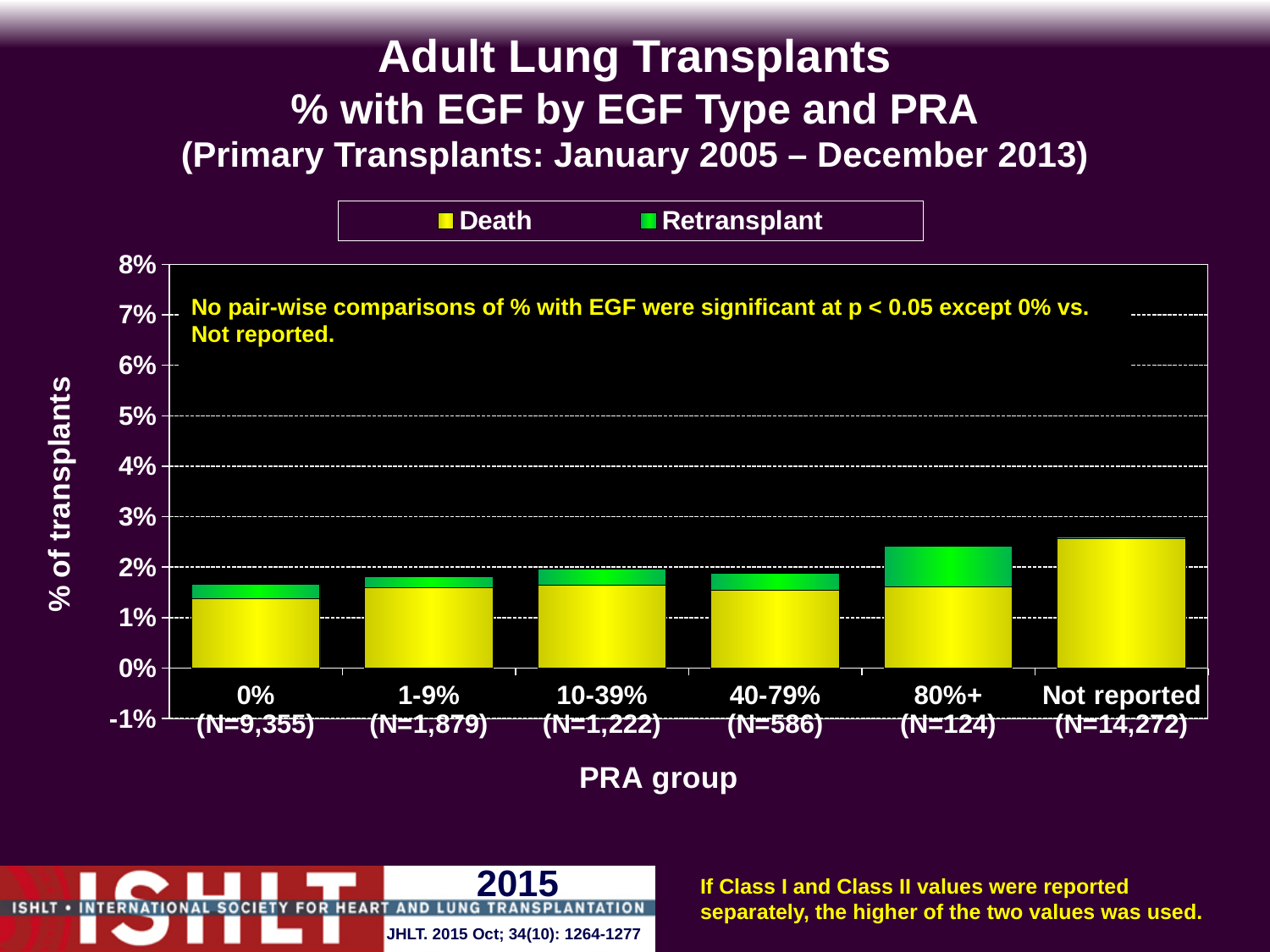
How many series does the legend list? 2 How many PRA groups are shown on the x axis? 6 What is the label of the x axis? PRA group Which has the larger total % with EGF, the Not reported group or the 1-9% group? Not reported Is the total % with EGF for the 0% PRA group greater or less than 2%? less Is the total % with EGF for the 80%+ PRA group greater or less than 2%? greater What kind of chart is shown on the slide? Stacked bar chart Which PRA group has the largest Retransplant segment? 80%+ What is the N shown for the Not reported PRA group? N=14,272 Is the total % with EGF for the Not reported group greater or less than 2%? greater Which has the larger total % with EGF, the 80%+ group or the 0% group? 80%+